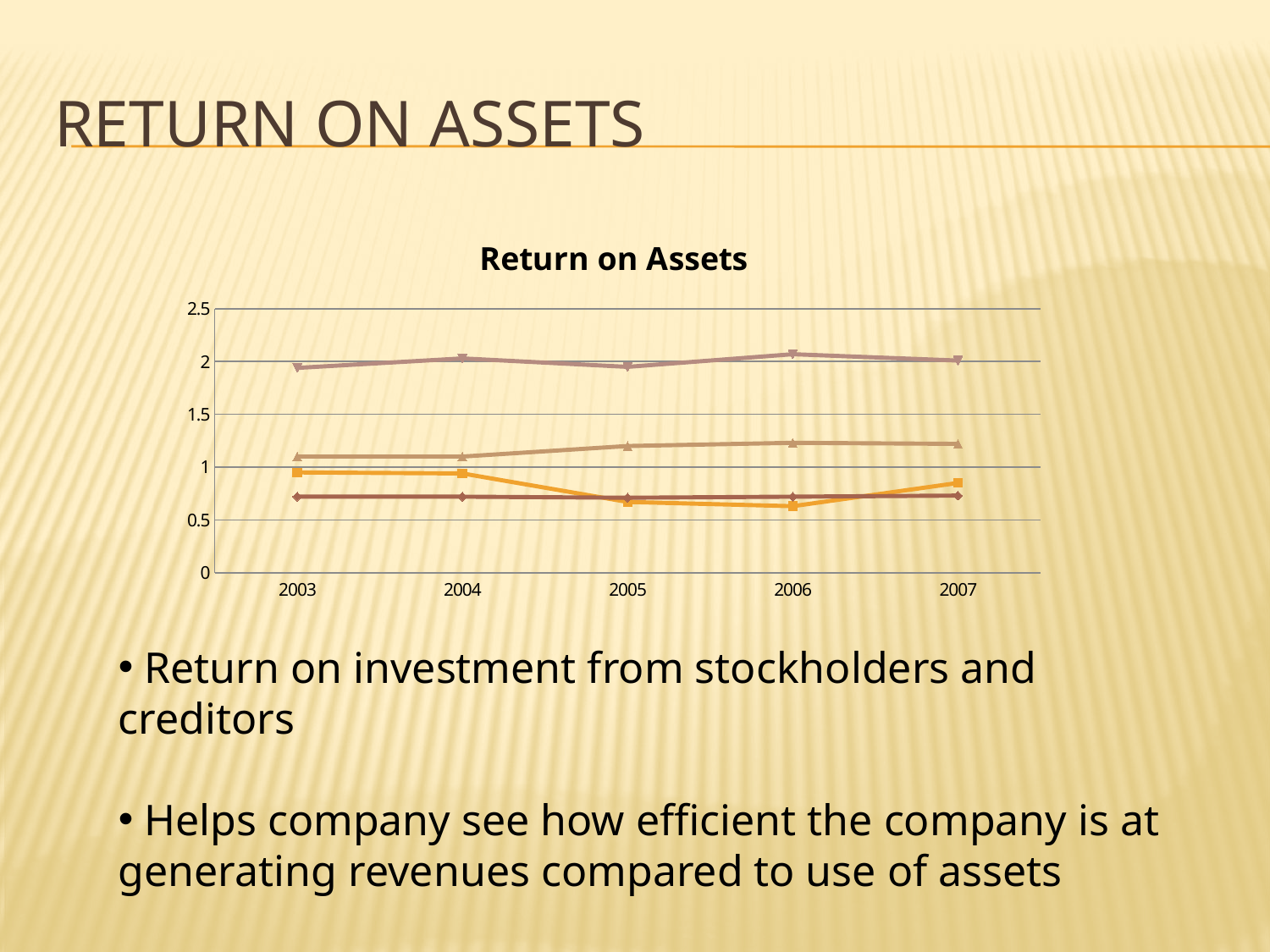
Is the value of the orange line with square markers in 2006 greater or less than 1? less Does the orange line with square markers rise or fall from 2004 to 2006? fall Is the value of the dark brown line with diamond markers in 2004 greater or less than 1? less How many years are shown on the x axis of the chart? 5 What is the title of the chart? Return on Assets In 2005, which is higher: the topmost line with inverted-triangle markers or the line with triangle markers? the line with inverted-triangle markers Is the value of the topmost line (inverted-triangle markers) in 2005 greater or less than 1.5? greater What kind of chart is shown on the slide? line chart What is the highest value shown on the y axis of the chart? 2.5 How many lines are plotted on the chart? 4